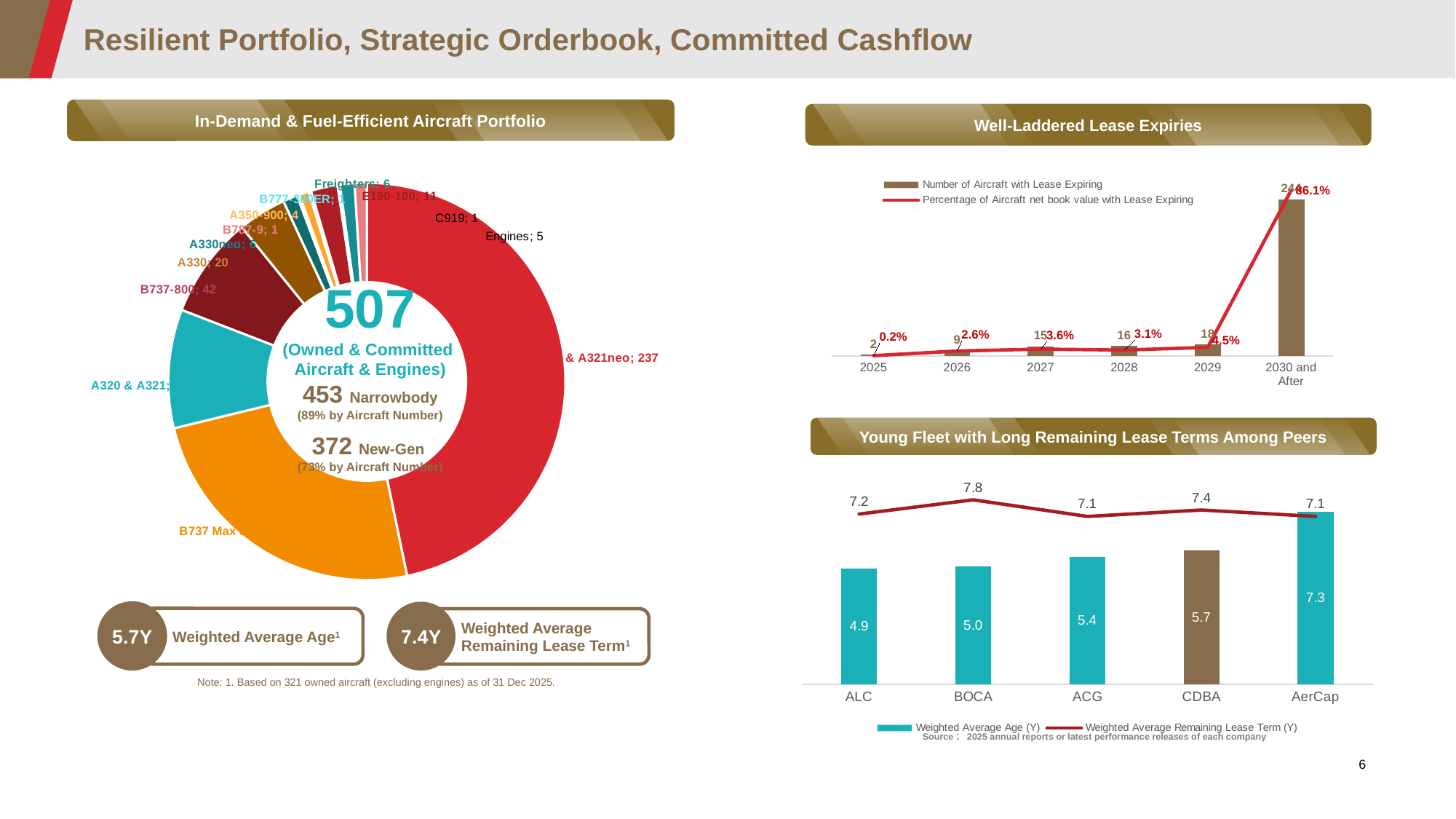
In the Young Fleet with Long Remaining Lease Terms Among Peers chart, do the weighted average age bars rise or fall from ALC to AerCap? rise In the Well-Laddered Lease Expiries chart, which period has the highest percentage of aircraft net book value with lease expiring? 2030 and After In the Well-Laddered Lease Expiries chart, what percentage of aircraft net book value has leases expiring in 2029? 4.5% In the Young Fleet with Long Remaining Lease Terms Among Peers chart, what is the weighted average age for CDBA? 5.7 In the Well-Laddered Lease Expiries chart, how many aircraft have leases expiring in 2028? 16 In the Young Fleet with Long Remaining Lease Terms Among Peers chart, what is the weighted average remaining lease term for BOCA? 7.8 In the Well-Laddered Lease Expiries chart, how many series does the legend list? 2 In the Well-Laddered Lease Expiries chart, how many periods are shown on the x axis? 6 In the Young Fleet with Long Remaining Lease Terms Among Peers chart, what is the difference in weighted average age between AerCap and ALC? 2.4 In the In-Demand & Fuel-Efficient Aircraft Portfolio chart, how many B737-800 aircraft are shown? 42 In the Well-Laddered Lease Expiries chart, which year has the lowest number of aircraft with lease expiring? 2025 In the Young Fleet with Long Remaining Lease Terms Among Peers chart, which company has the highest weighted average age? AerCap